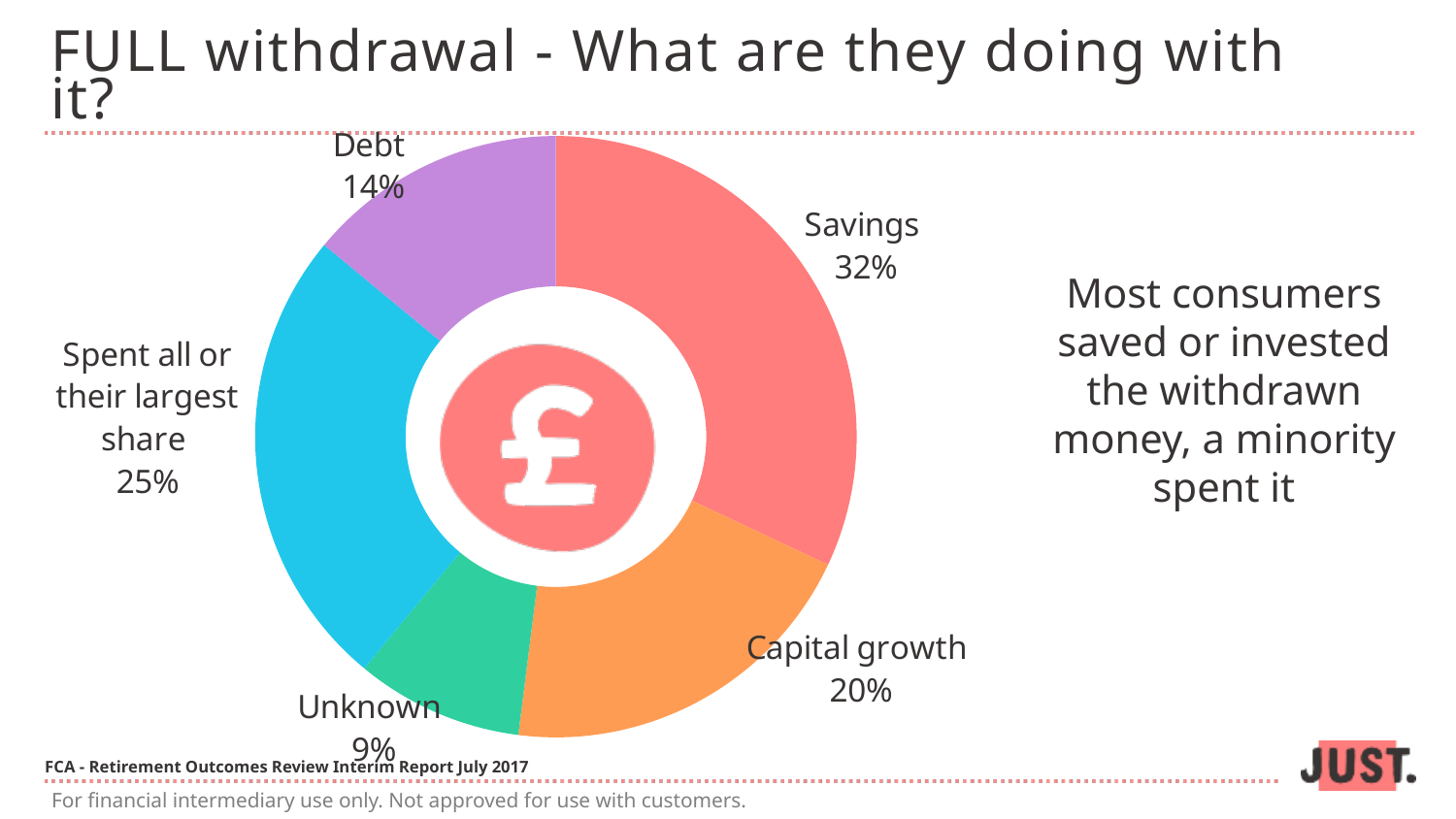
How many categories are shown in the chart? 5 What percentage of the chart is labelled Debt? 14% What percentage of the chart is labelled 'Spent all or their largest share'? 25% Which category has the largest share of the chart? Savings What percentage of the chart is labelled Savings? 32% Which is larger, the share for Debt or the share for Spent all or their largest share? Spent all or their largest share What symbol is shown in the centre of the chart? £ What is the difference in percentage points between Savings and Capital growth? 12 What percentage of the chart is labelled Unknown? 9% What percentage of the chart is labelled Capital growth? 20% What kind of chart is shown on the slide? Doughnut (pie) chart Which category has the smallest share of the chart? Unknown